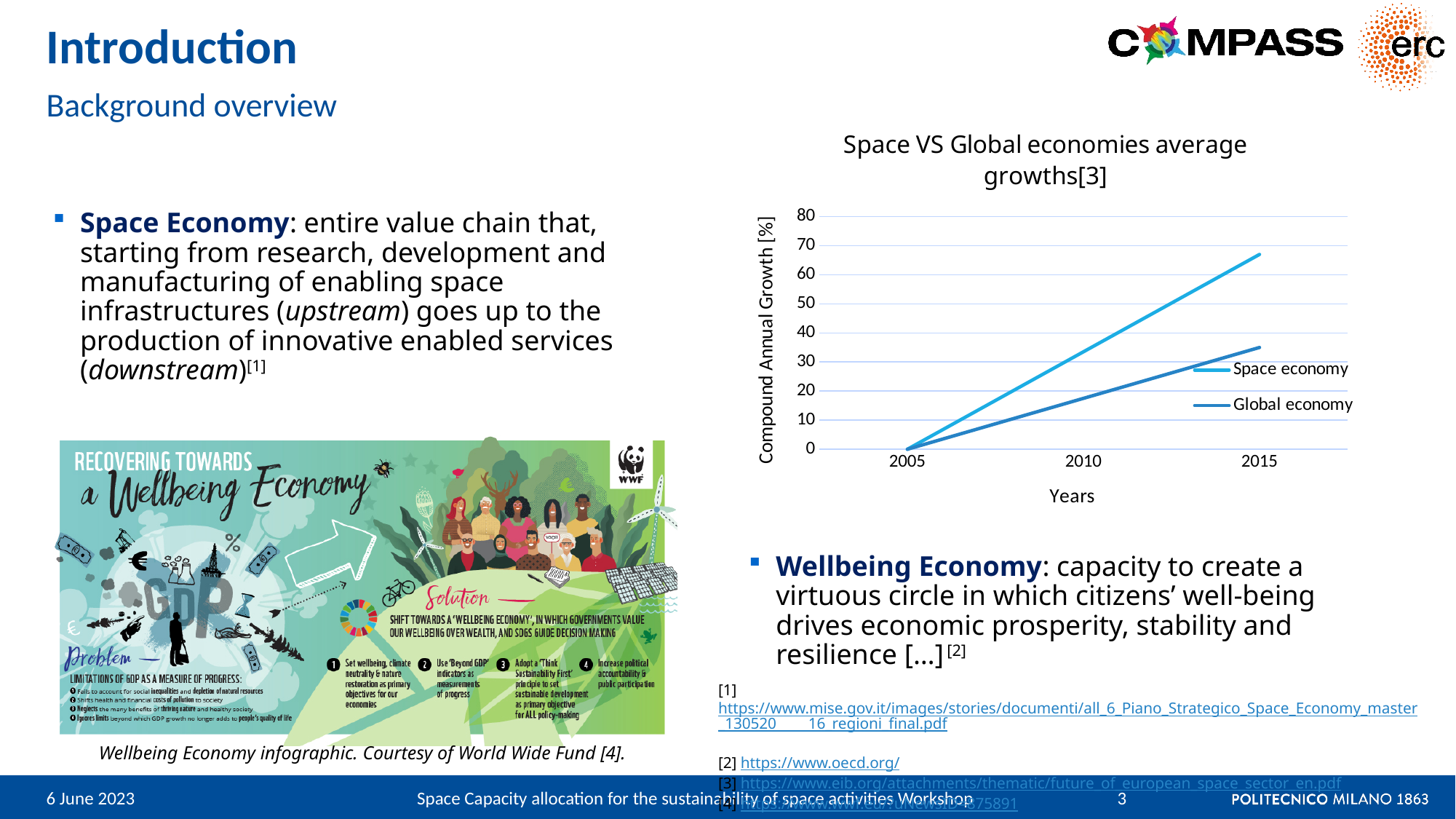
Is the value for Global economy in 2015 greater or less than 40? less What is the value of the Space economy series in 2005? 0 How many series does the chart's legend list? 2 How many years are labelled on the x axis of the chart? 3 What type of chart is shown on the slide? line chart Is the value for Space economy in 2015 greater or less than 70? less Which series are listed in the chart's legend? Space economy, Global economy Which series has the higher value in 2015, Space economy or Global economy? Space economy Is the value for Global economy in 2010 greater or less than 20? less What is the title of the chart on the slide? Space VS Global economies average growths[3] Do the values of the Space economy series rise or fall from 2005 to 2015? rise